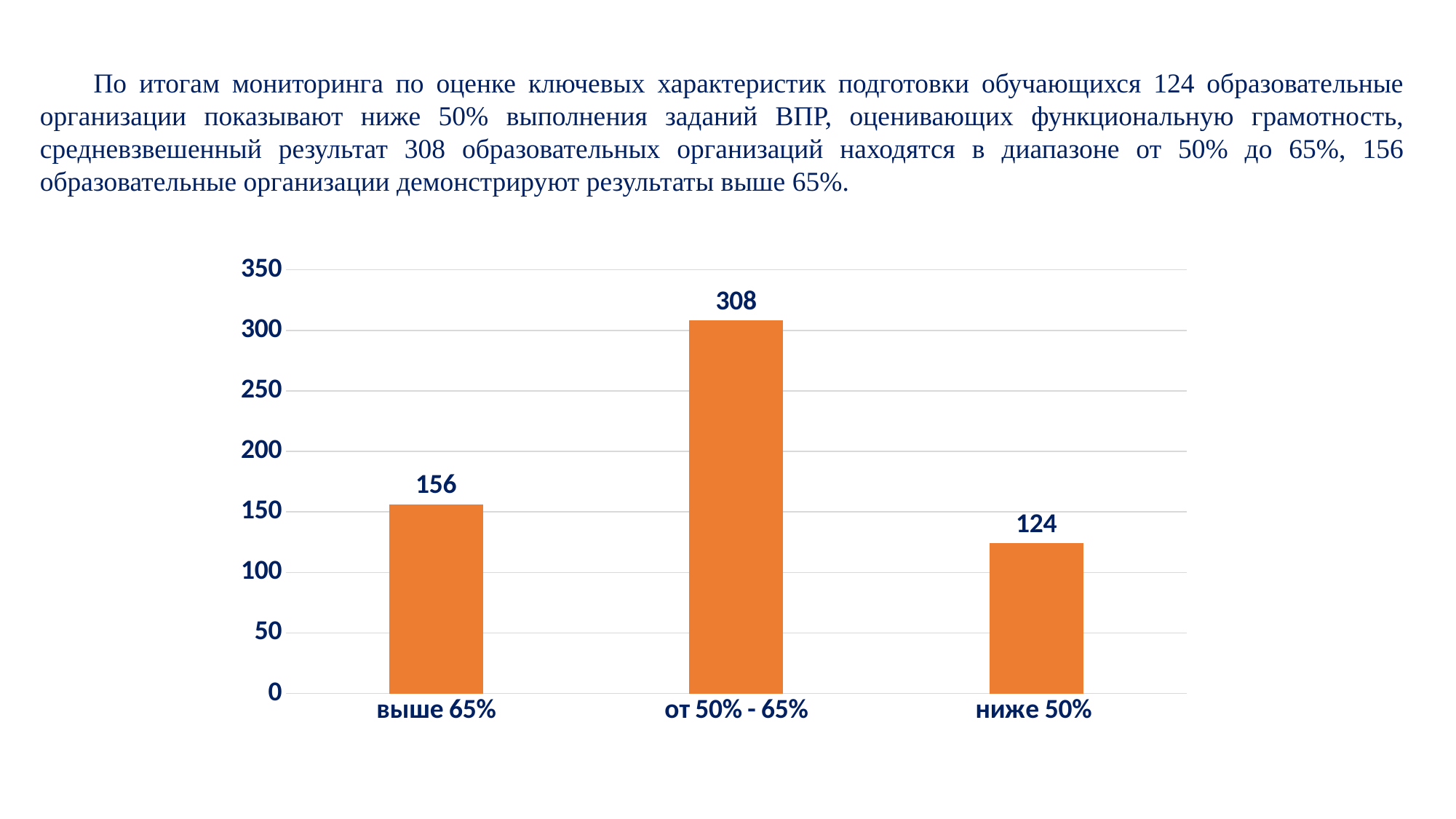
How many categories are shown on the x axis? 3 What is the value for the category "ниже 50%"? 124 Which category has the lowest value? ниже 50% Which is larger, the value for "выше 65%" or the value for "ниже 50%"? выше 65% What kind of chart is shown on the slide? bar chart What is the value for the category "от 50% - 65%"? 308 Is the value for "от 50% - 65%" greater or less than 300? greater What is the difference between the values for "выше 65%" and "ниже 50%"? 32 What is the value for the category "выше 65%"? 156 What is the highest value shown on the vertical axis? 350 Which category has the highest value? от 50% - 65% What is the difference between the values for "от 50% - 65%" and "ниже 50%"? 184